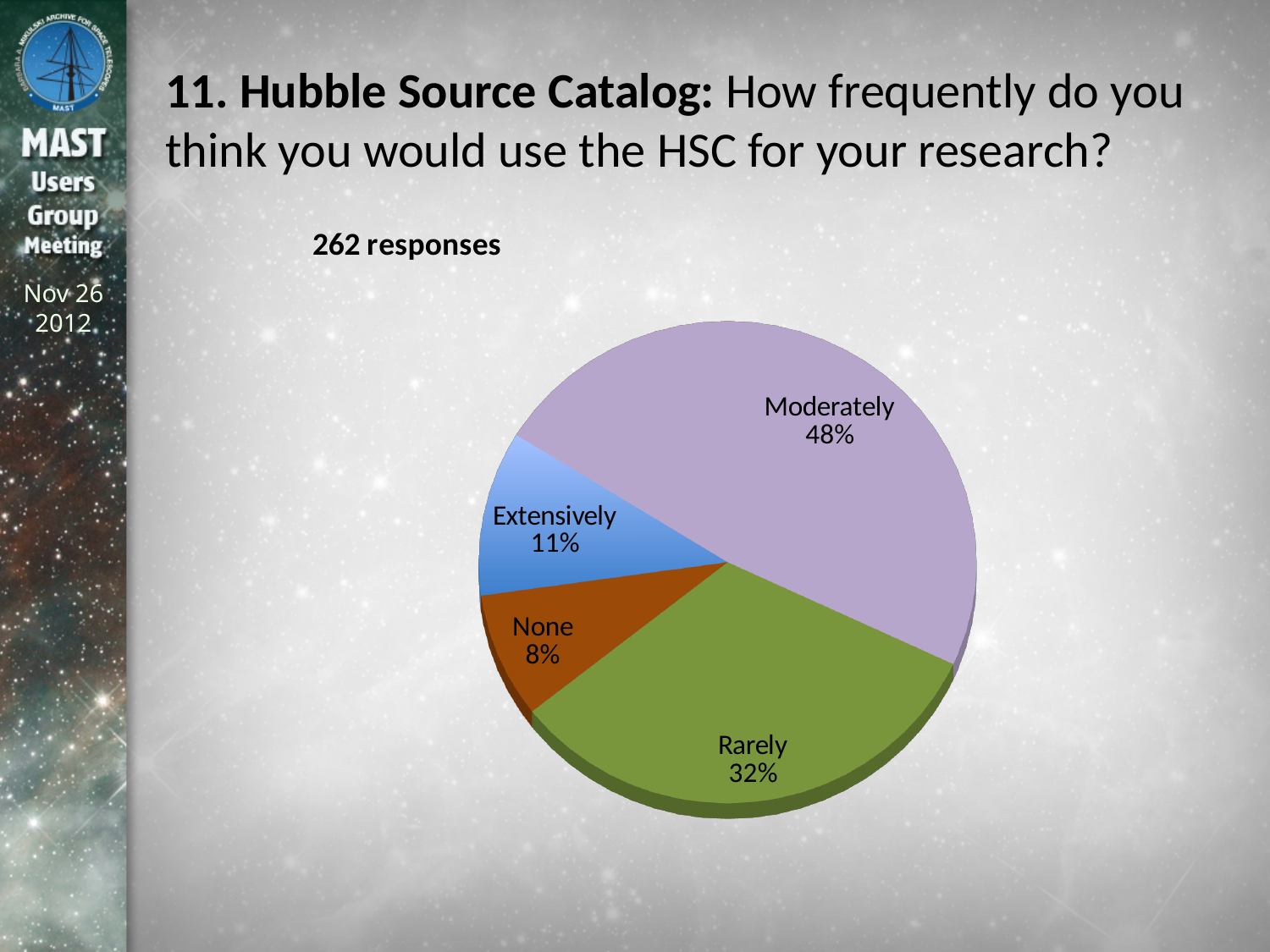
Which response category has the smallest share of the pie? None What is the difference in percentage points between the Moderately and Rarely slices? 16 How many categories are shown in the pie chart? 4 What percentage of respondents said they would use the HSC moderately? 48% What colour is the Rarely slice of the pie? green Which slice is larger, Extensively or None? Extensively Which response category has the largest share of the pie? Moderately What percentage of respondents said they would use the HSC rarely? 32% What kind of chart is shown on the slide? pie chart How many responses does the slide say the chart is based on? 262 responses What percentage of respondents said they would not use the HSC at all (None)? 8% What percentage of respondents said they would use the HSC extensively? 11%